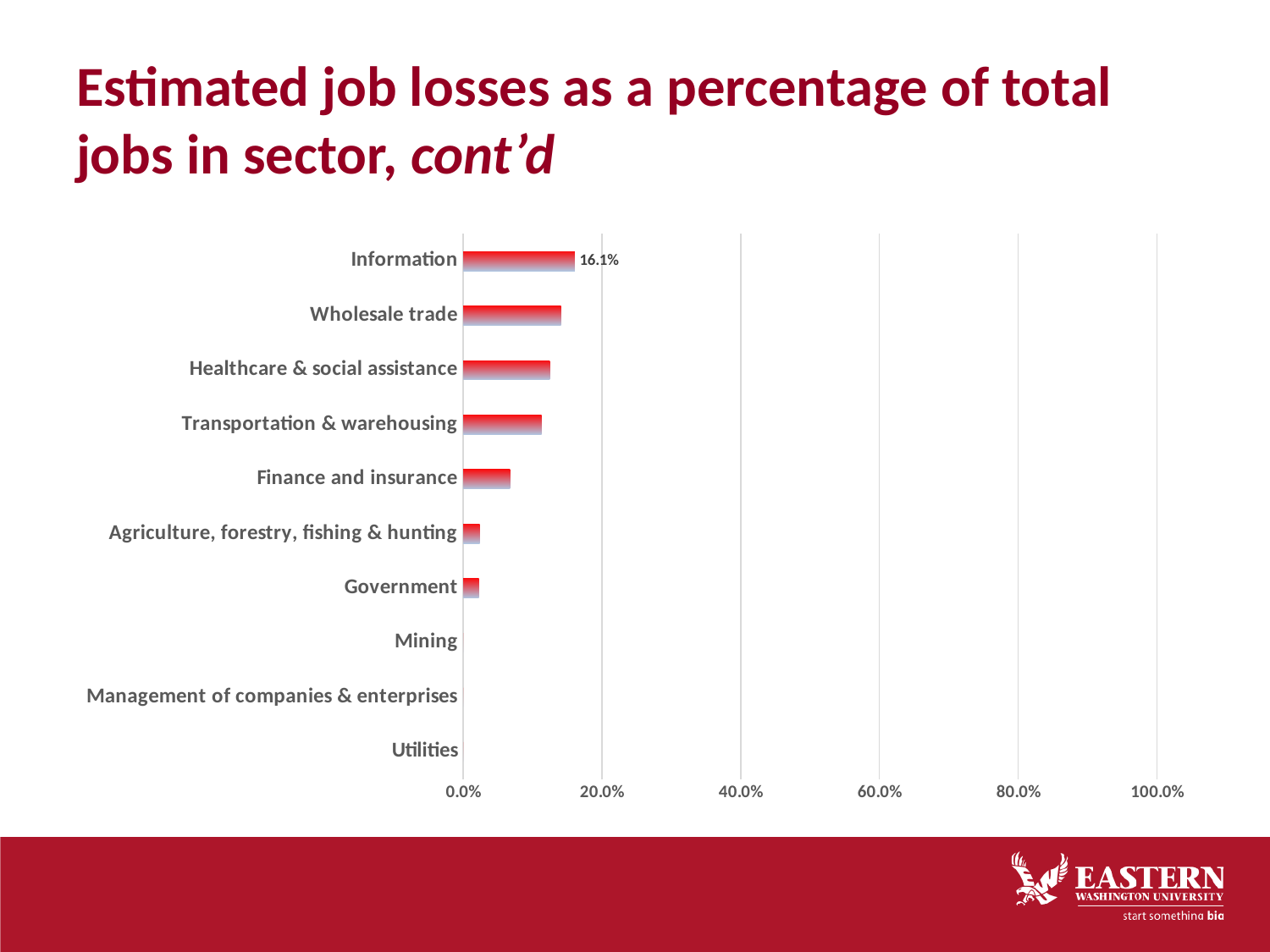
Is the value for Information greater or less than 20.0%? less Is the value for Finance and insurance greater or less than 20.0%? less Which is larger, the value for Transportation & warehousing or the value for Agriculture, forestry, fishing & hunting? Transportation & warehousing Is the value for Wholesale trade greater or less than 20.0%? less What is the highest value shown on the horizontal axis? 100.0% What is the estimated job loss percentage for Information? 16.1% Which sector is listed at the bottom of the chart? Utilities What kind of chart is shown on the slide? bar chart How many sectors are listed on the chart? 10 Which sector has the highest estimated job loss percentage? Information Which is larger, the value for Healthcare & social assistance or the value for Finance and insurance? Healthcare & social assistance Which is larger, the value for Wholesale trade or the value for Government? Wholesale trade